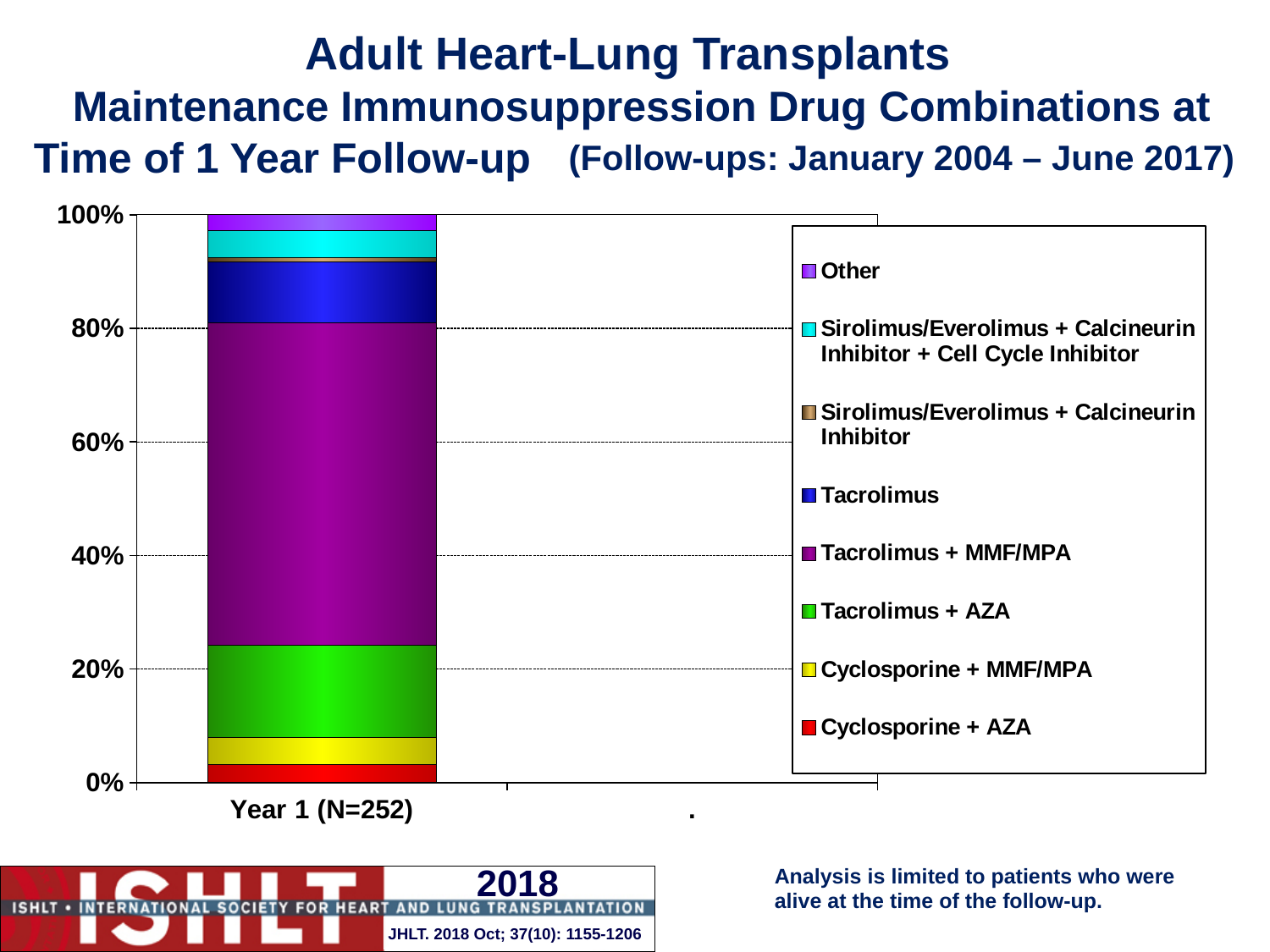
Is the share for Tacrolimus + AZA in the Year 1 bar greater or less than 20%? less Which drug combination makes up the largest segment of the Year 1 bar? Tacrolimus + MMF/MPA What is the total height of the stacked Year 1 bar? 100% What is the N value shown for the Year 1 category? 252 Which segment is larger in the Year 1 bar: Tacrolimus + MMF/MPA or Tacrolimus + AZA? Tacrolimus + MMF/MPA How many bars (categories) are plotted on the x axis? 1 What kind of chart is shown on the slide? Stacked bar chart How many series does the legend list? 8 Which colour represents Tacrolimus + MMF/MPA in the legend? Purple Which drug combination makes up the smallest segment of the Year 1 bar? Sirolimus/Everolimus + Calcineurin Inhibitor Is the share for Tacrolimus + MMF/MPA in the Year 1 bar greater or less than 40%? greater Which segment is larger in the Year 1 bar: Tacrolimus + AZA or Cyclosporine + AZA? Tacrolimus + AZA